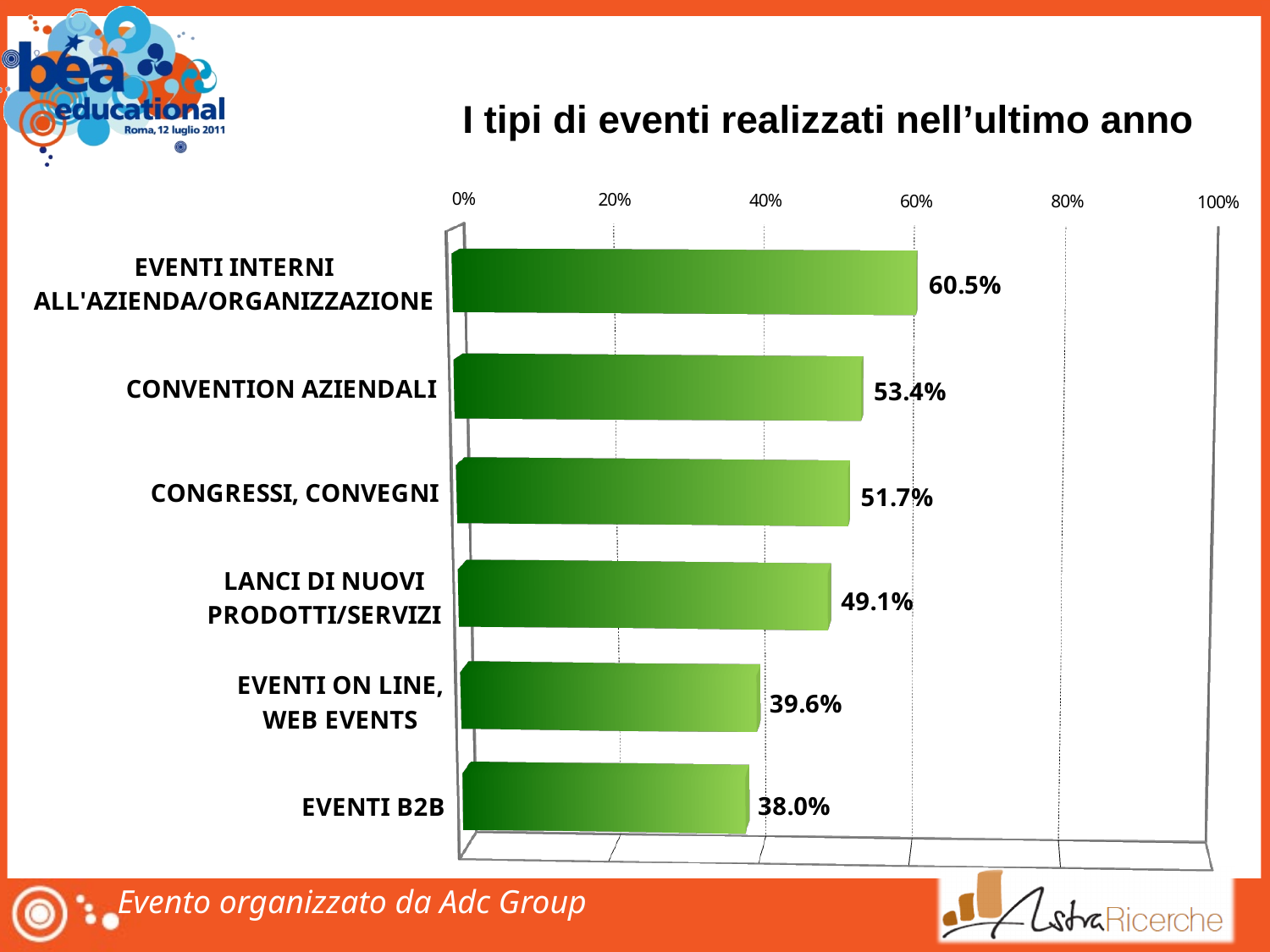
What is the value for EVENTI B2B? 38.0% Is the value for LANCI DI NUOVI PRODOTTI/SERVIZI greater or less than 40%? greater What kind of chart is shown on the slide? bar chart Which is larger, the value for CONVENTION AZIENDALI or the value for EVENTI ON LINE, WEB EVENTS? CONVENTION AZIENDALI What is the difference between the values for CONGRESSI, CONVEGNI and LANCI DI NUOVI PRODOTTI/SERVIZI? 2.6% How many categories are shown in the chart? 6 Which category has the highest value? EVENTI INTERNI ALL'AZIENDA/ORGANIZZAZIONE Which category has the lowest value? EVENTI B2B What is the value for EVENTI ON LINE, WEB EVENTS? 39.6% What is the value for CONVENTION AZIENDALI? 53.4% What is the value for EVENTI INTERNI ALL'AZIENDA/ORGANIZZAZIONE? 60.5% What is the title of the chart? I tipi di eventi realizzati nell'ultimo anno